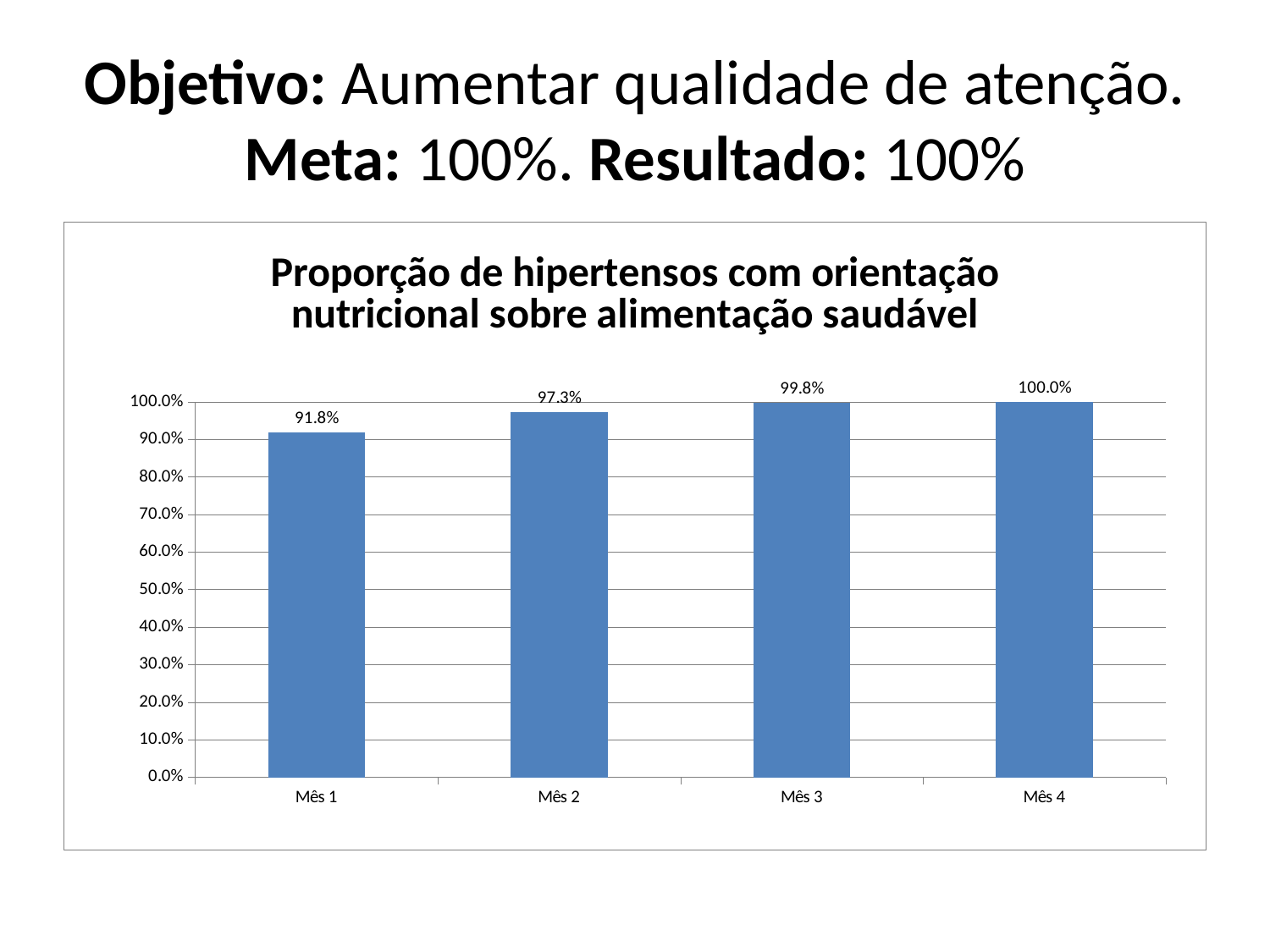
Which month has the lowest value? Mês 1 What is the value for Mês 2? 97.3% What is the value for Mês 1? 91.8% What is the value for Mês 3? 99.8% What is the value for Mês 4? 100.0% What kind of chart is shown on the slide? bar chart Do the values rise or fall from Mês 1 to Mês 4? rise How many months are shown on the x axis? 4 Which month has the highest value? Mês 4 Which is larger, the value for Mês 1 or the value for Mês 2? Mês 2 What is the difference between the values for Mês 2 and Mês 1? 5.5% Is the value for Mês 1 greater or less than 90.0%? greater